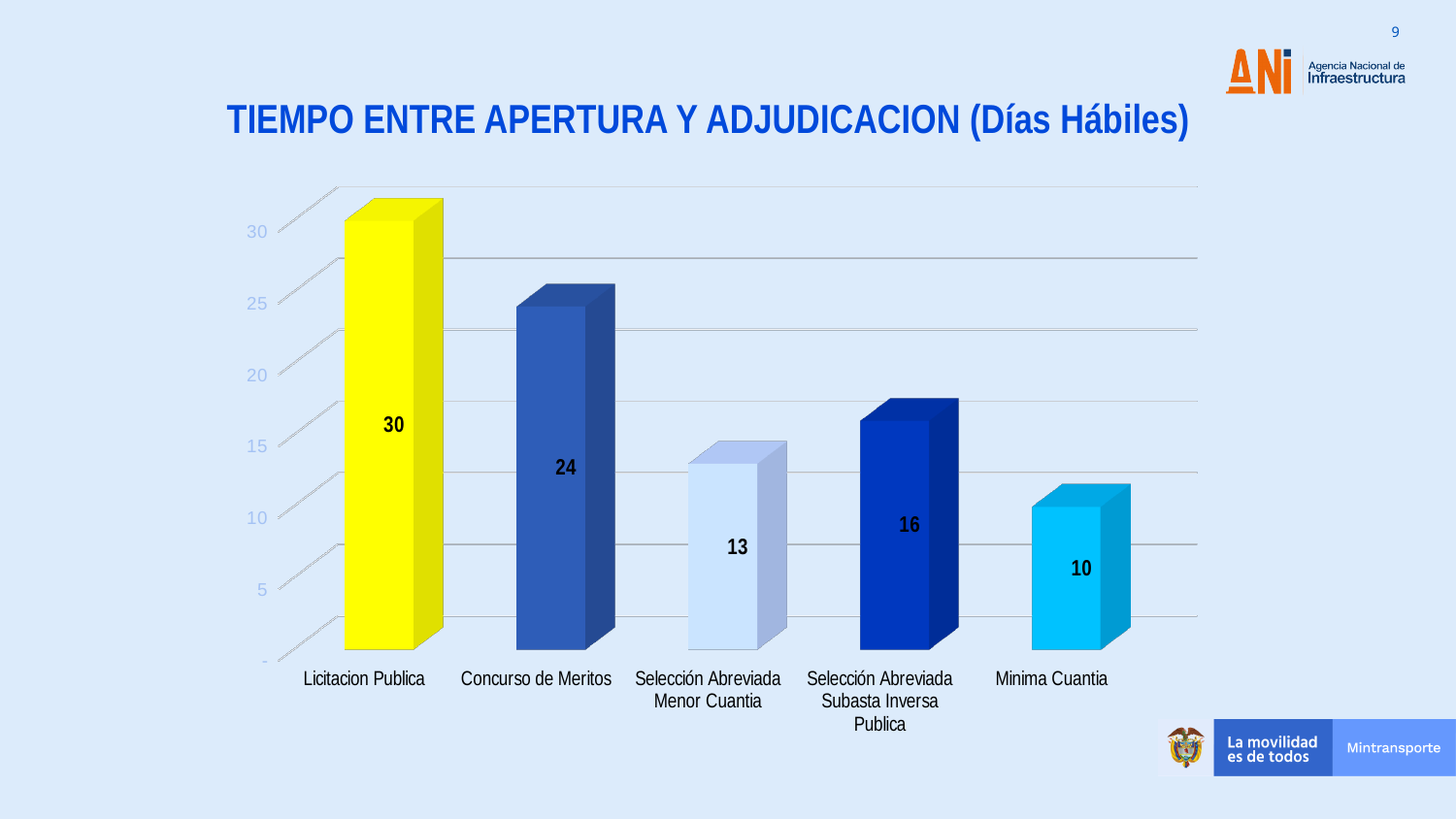
What is the title of the chart? TIEMPO ENTRE APERTURA Y ADJUDICACION (Días Hábiles) Which category has the lowest value? Minima Cuantia Is the value for Selección Abreviada Subasta Inversa Publica greater or less than 20? less What is the value for Concurso de Meritos? 24 What is the value for Licitacion Publica? 30 What is the difference between the values for Licitacion Publica and Concurso de Meritos? 6 What is the value for Minima Cuantia? 10 How many categories are shown in the chart? 5 What is the value for Selección Abreviada Menor Cuantia? 13 Which is larger, the value for Selección Abreviada Subasta Inversa Publica or Selección Abreviada Menor Cuantia? Selección Abreviada Subasta Inversa Publica Which category has the highest value? Licitacion Publica What kind of chart is shown on the slide? bar chart